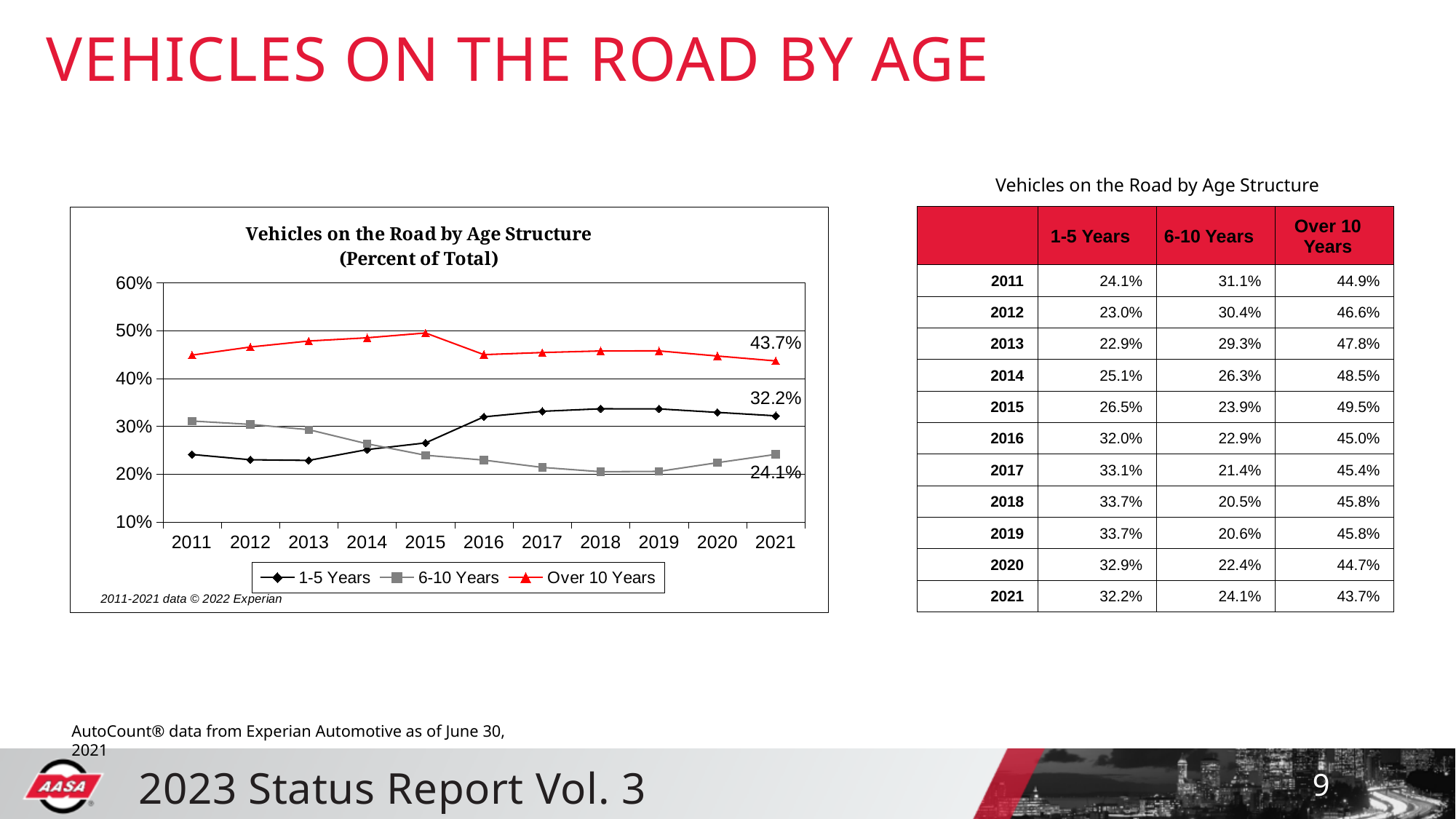
In 2011, which is larger: the 1-5 Years value or the 6-10 Years value? 6-10 Years Is the value for Over 10 Years in 2015 greater or less than 40%? greater What is the value labelled for 6-10 Years in 2021? 24.1% How many years are plotted along the x axis of the chart? 11 Which series has the lowest value in 2021? 6-10 Years What is the difference between the Over 10 Years and 1-5 Years values in 2021? 11.5% What is the value labelled for 1-5 Years in 2021? 32.2% Does the 1-5 Years series rise or fall between 2013 and 2018? Rise How many series does the chart's legend list? 3 What kind of chart is shown on the slide? Line chart What is the value labelled for Over 10 Years in 2021? 43.7% Which series has the highest value in 2021? Over 10 Years